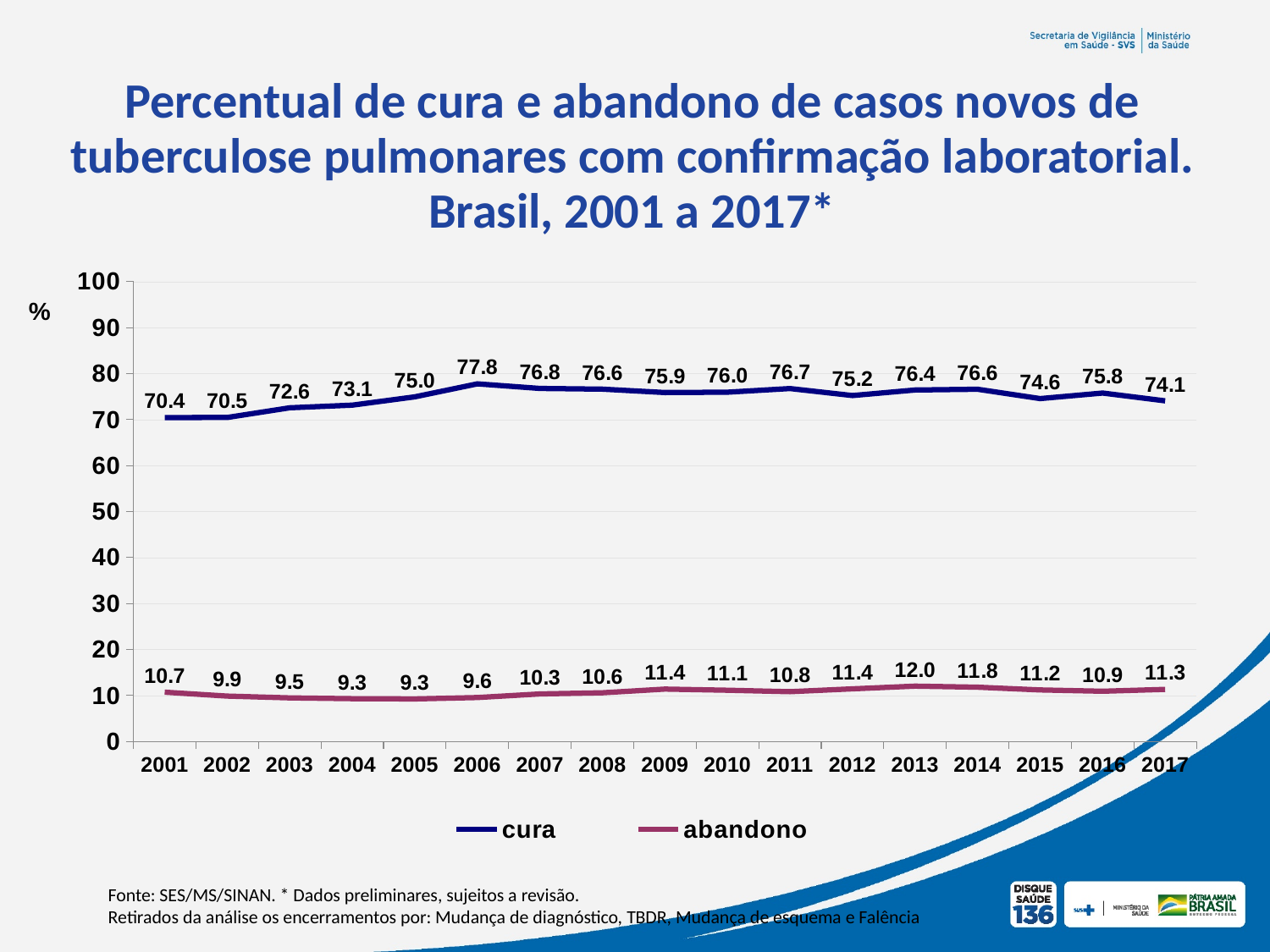
What kind of chart is shown on the slide? line chart What is the difference between the cura values for 2017 and 2001? 3.7 What is the cura value for 2017? 74.1 Does the cura value rise or fall from 2001 to 2006? rise In which year is the cura value highest? 2006 What is the cura value for 2006? 77.8 How many series does the legend list? 2 In which year is the cura value lowest? 2001 In which year is the abandono value highest? 2013 What is the abandono value for 2013? 12.0 Which is larger, the abandono value for 2009 or for 2010? 2009 How many years are shown on the x axis? 17